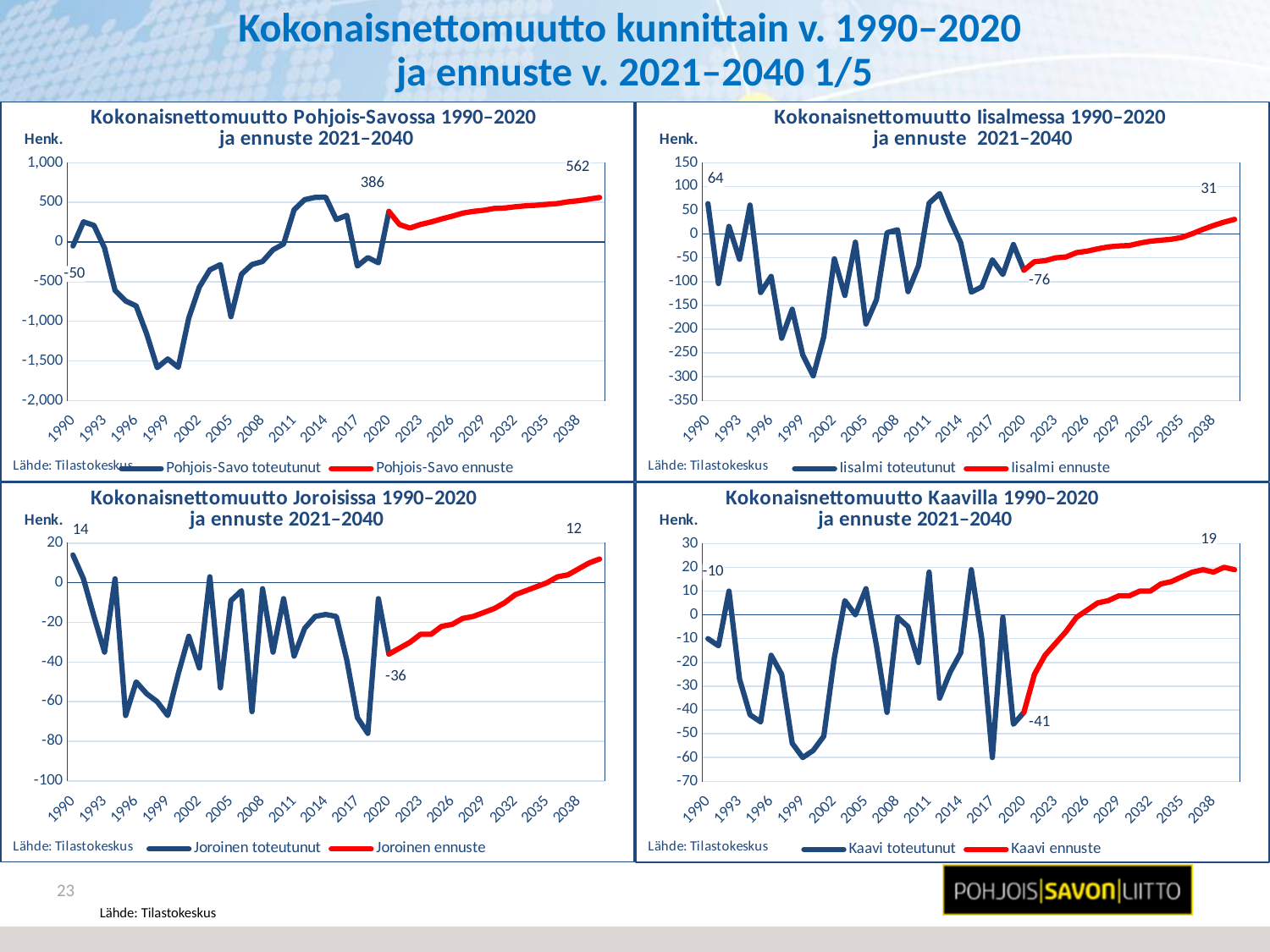
In the Iisalmi chart (top right), what is the labelled value for 1990? 64 What kind of chart is the Kaavi chart (bottom right)? line chart In the Kaavi chart (bottom right), what is the difference between the labelled 2040 value and the labelled 2020 value? 60 In the Kaavi chart (bottom right), what is the labelled value for 2020? -41 In the Iisalmi chart (top right), what is the labelled value for 2020? -76 How many series does the legend of the Joroinen chart (bottom left) list? 2 In the Joroinen chart (bottom left), which labelled value is larger: 1990 or 2040? 1990 In the Pohjois-Savo chart (top left), what is the labelled value for 2040? 562 In the Joroinen chart (bottom left), what is the labelled value for 2040? 12 In the Pohjois-Savo chart (top left), what is the difference between the labelled 2040 value and the labelled 2020 value? 176 In the Pohjois-Savo chart (top left), what is the labelled value for 2020? 386